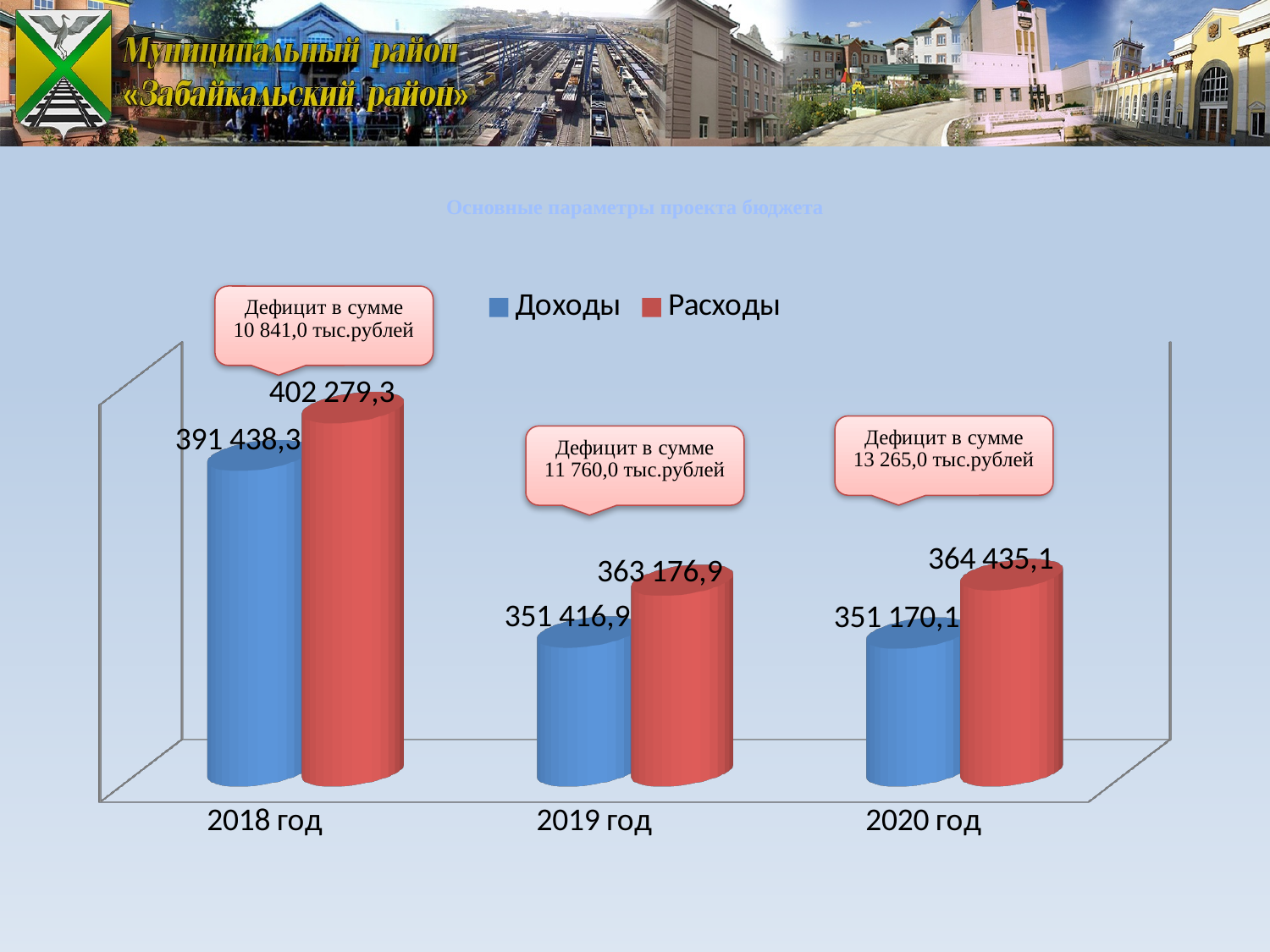
What is the value of Доходы for 2018 год? 391 438,3 Which is larger in 2020 год, Доходы or Расходы? Расходы What type of chart is shown on the slide? Bar chart What are the two legend entries of the chart? Доходы and Расходы What is the difference between Расходы and Доходы in 2019 год? 11 760,0 What is the value of Расходы for 2020 год? 364 435,1 In which year is Расходы the highest? 2018 год Do the Доходы values rise or fall from 2018 год to 2020 год? Fall What is the value of Доходы for 2019 год? 351 416,9 What is the value of Расходы for 2018 год? 402 279,3 How many year categories are shown on the x axis of the chart? 3 How many series does the chart legend list? 2